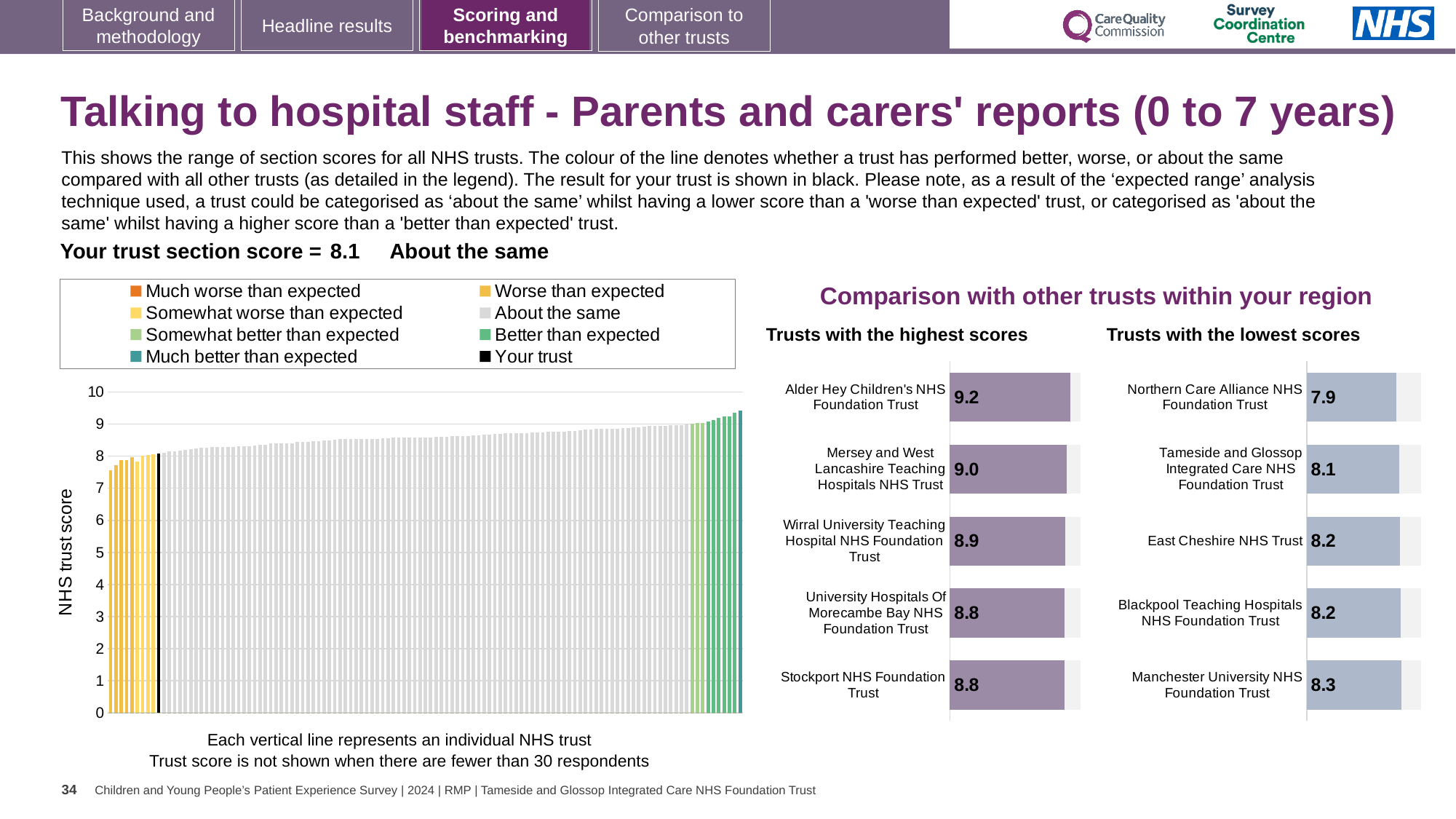
What kind of chart is the large chart on the left of the slide? bar chart In the 'Trusts with the highest scores' chart, what is the score for Wirral University Teaching Hospital NHS Foundation Trust? 8.9 In the 'Trusts with the lowest scores' chart, what is the difference between the scores of Manchester University NHS Foundation Trust and Northern Care Alliance NHS Foundation Trust? 0.4 In the 'Trusts with the lowest scores' chart, which has the higher score: Tameside and Glossop Integrated Care NHS Foundation Trust or East Cheshire NHS Trust? East Cheshire NHS Trust In the large chart on the left, is the value for the black bar (your trust) greater or less than 5? greater In the 'Trusts with the highest scores' chart, what is the score for Alder Hey Children's NHS Foundation Trust? 9.2 In the 'Trusts with the lowest scores' chart, what is the score for Northern Care Alliance NHS Foundation Trust? 7.9 How many trusts are shown in the 'Trusts with the highest scores' chart? 5 In the 'Trusts with the lowest scores' chart, which trust has the lowest score? Northern Care Alliance NHS Foundation Trust In the large chart on the left, do the trust scores rise or fall from left to right along the x axis? rise How many entries does the legend above the large chart on the left list? 8 In the 'Trusts with the highest scores' chart, which trust has the highest score? Alder Hey Children's NHS Foundation Trust